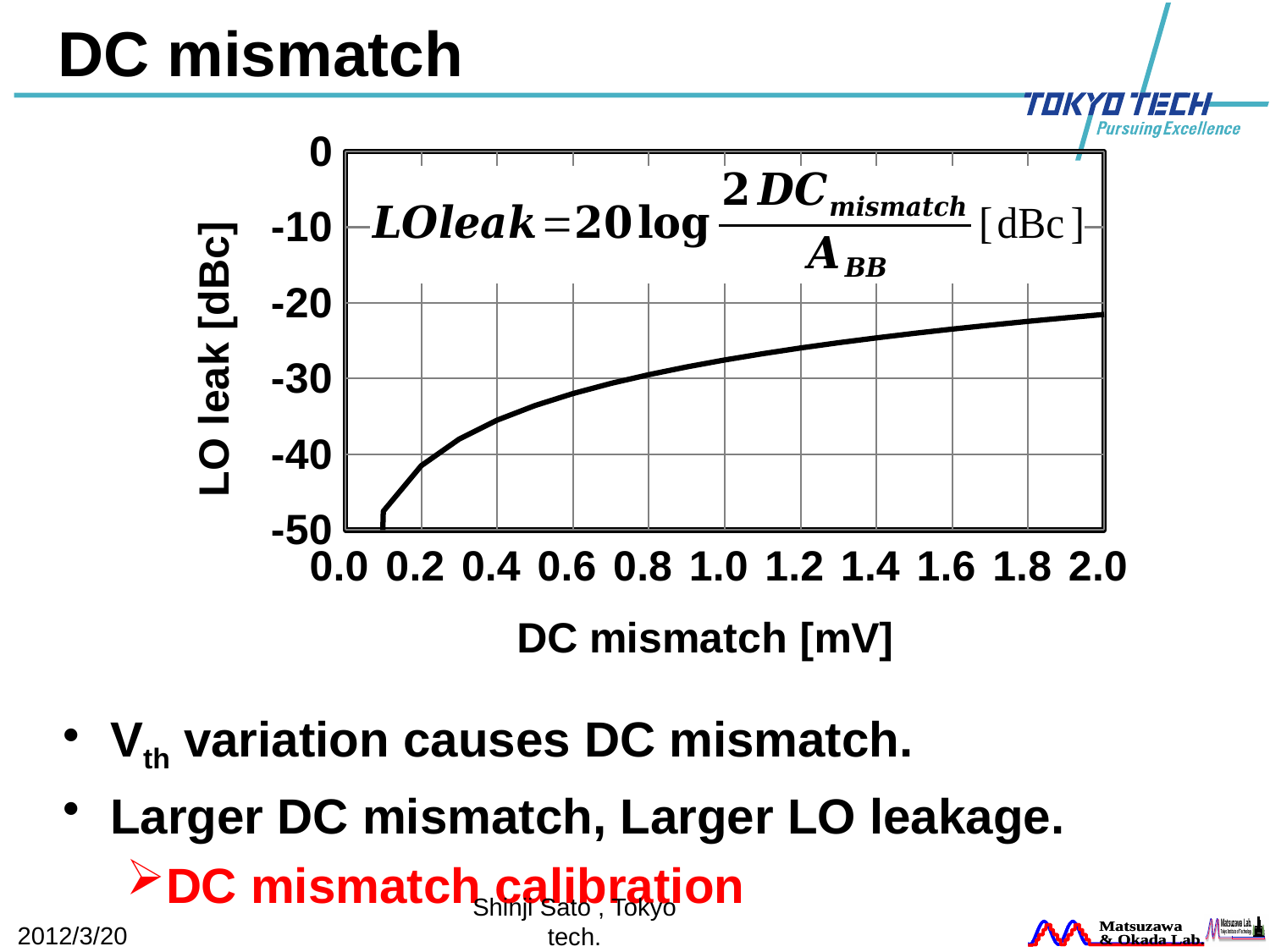
Is the LO leak value at a DC mismatch of 0.4 mV greater or less than -40 dBc? greater Is the LO leak value at a DC mismatch of 0.6 mV greater or less than -30 dBc? less Is the LO leak value at a DC mismatch of 2.0 mV greater or less than -20 dBc? less What is the label of the x axis of the chart? DC mismatch [mV] What is the label of the y axis of the chart? LO leak [dBc] Does LO leak rise or fall as DC mismatch increases along the x axis? rise What kind of chart is shown on the slide? line chart